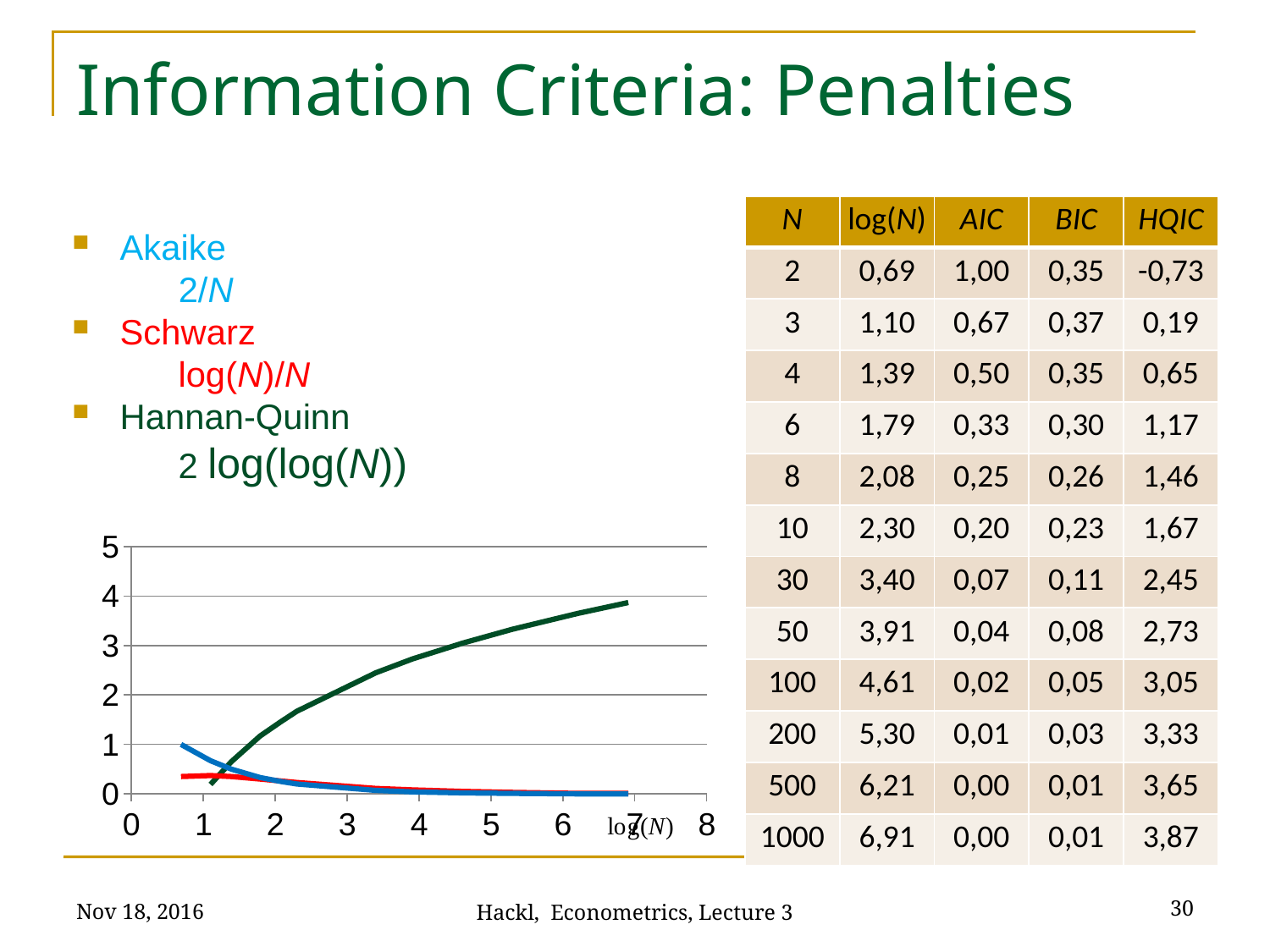
Is the value of the blue line at log(N) = 3 greater or less than 1? less Which line is highest at the left end of the chart (around log(N) = 1)? blue Does the blue line rise or fall as log(N) increases? fall What is the label on the x axis of the chart? log(N) What is the highest tick value shown on the y axis of the chart? 5 At log(N) = 6, which line has the larger value, the green line or the red line? green How many lines are plotted in the chart? 3 What kind of chart is shown at the bottom left of the slide? line chart Which line is highest at the right end of the chart (around log(N) = 7)? green Is the value of the green line at log(N) = 7 greater or less than 4? less Does the green line rise or fall as log(N) increases? rise Is the value of the green line at log(N) = 7 greater or less than 3? greater